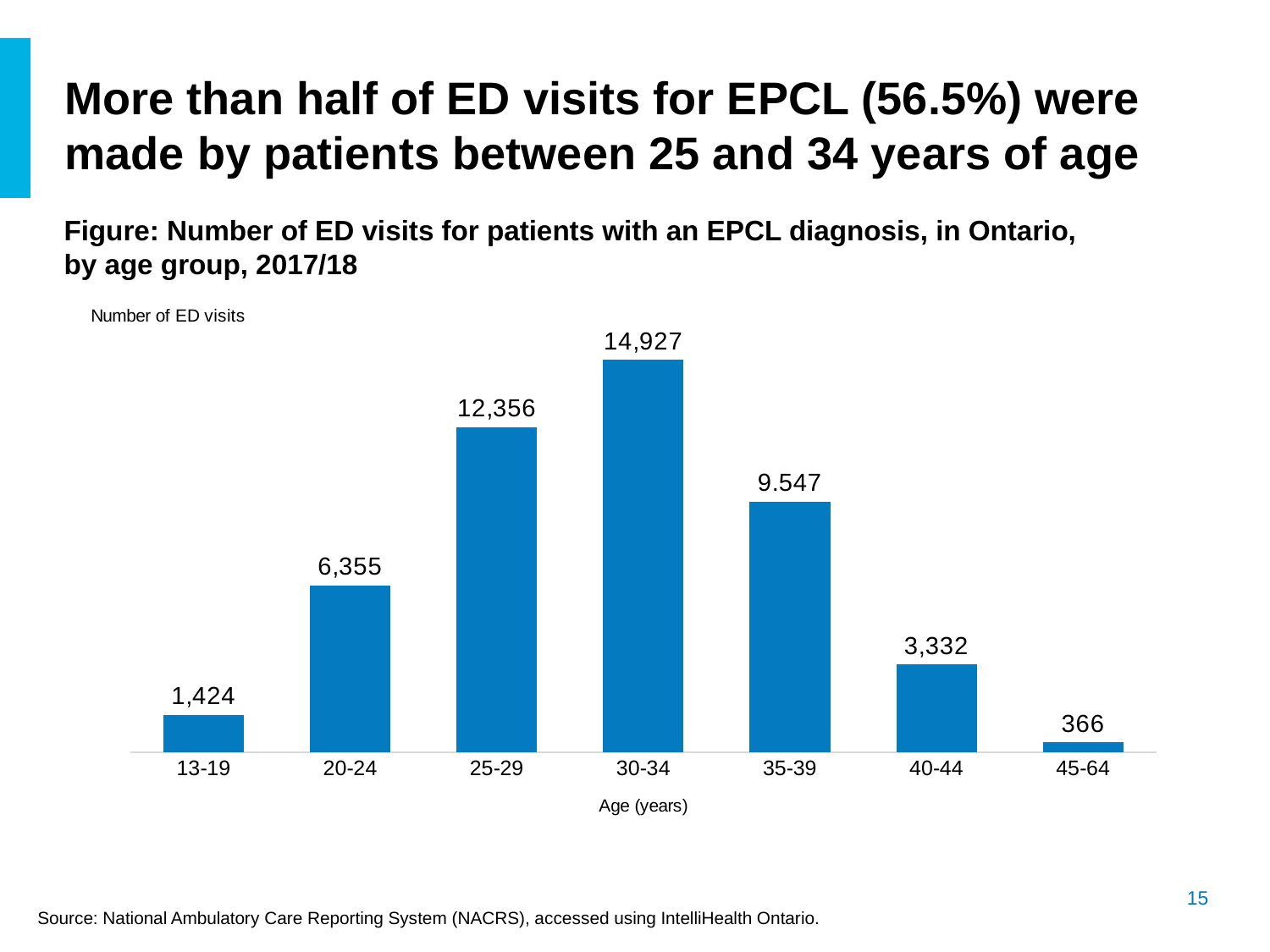
Which age group has the highest number of ED visits? 30-34 Do the values rise or fall from the 30-34 age group to the 45-64 age group? Fall What is the difference in ED visits between the 30-34 and 25-29 age groups? 2,571 How many ED visits were made by patients aged 30-34? 14,927 What kind of chart is shown on the slide? Bar chart What is the number of ED visits for the 40-44 age group? 3,332 Which age group has more ED visits, 25-29 or 35-39? 25-29 What value is shown for the 45-64 age group? 366 How many age groups are shown on the chart? 7 What is the difference in ED visits between the 20-24 and 13-19 age groups? 4,931 Which age group has the lowest number of ED visits? 45-64 What is the number of ED visits for the 20-24 age group? 6,355